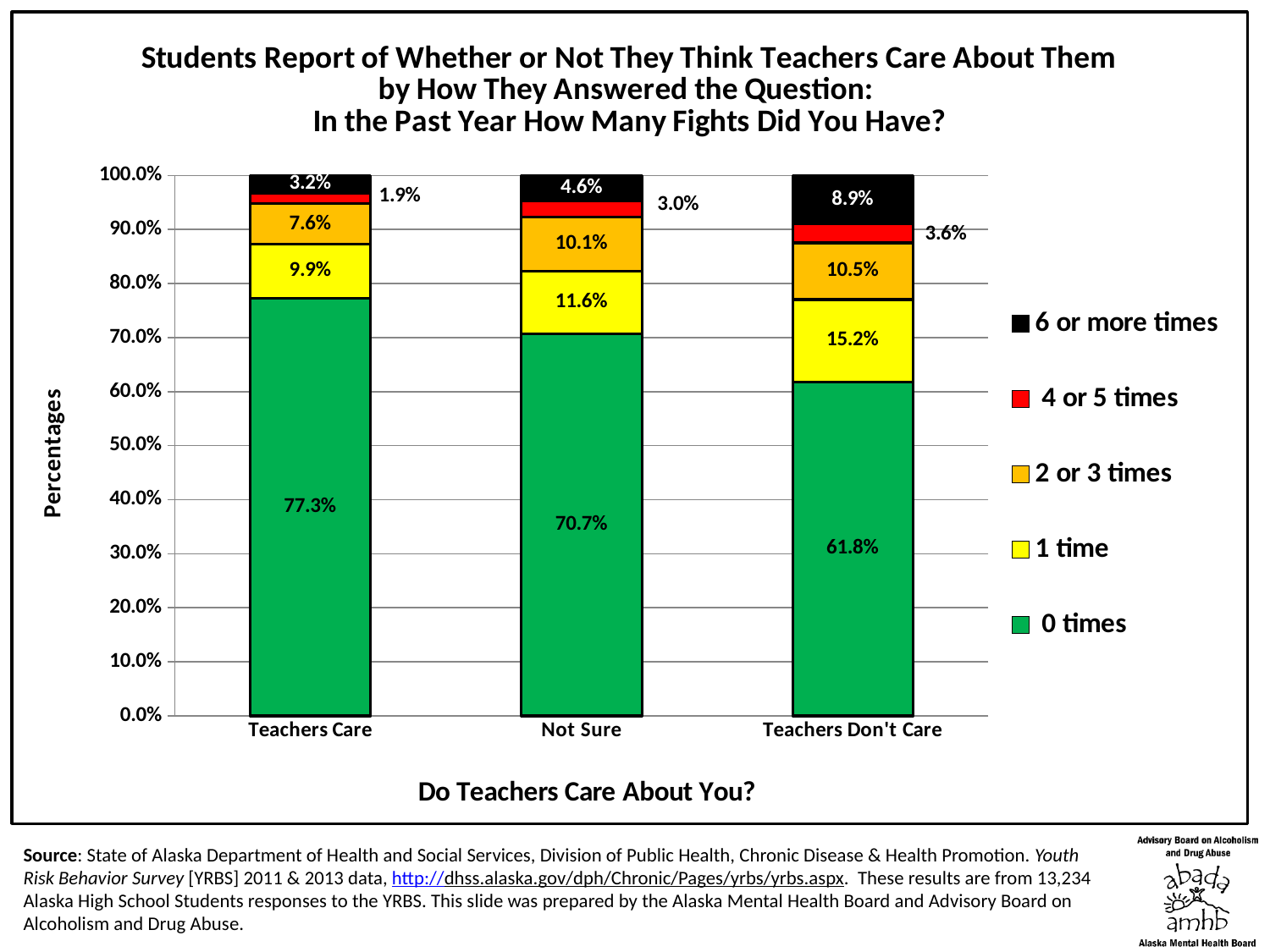
Which response category has the highest percentage of students reporting 0 fights? Teachers Care What percentage of students who answered "Teachers Don't Care" reported 6 or more fights? 8.9% How many series does the legend list? 5 What colour represents the "0 times" series in the chart? Green What kind of chart is shown on the slide? Stacked bar chart What percentage of students who answered "Not Sure" reported 1 fight? 11.6% Which is larger: the 2 or 3 times percentage for "Not Sure" or for "Teachers Don't Care"? Teachers Don't Care What percentage of students who answered "Teachers Care" reported 4 or 5 fights? 1.9% How many response categories are shown on the x axis? 3 Which response category has the lowest percentage of students reporting 6 or more fights? Teachers Care What percentage of students who answered "Teachers Care" reported 0 fights? 77.3% What is the difference between the 0 times percentage for "Teachers Care" and for "Teachers Don't Care"? 15.5%